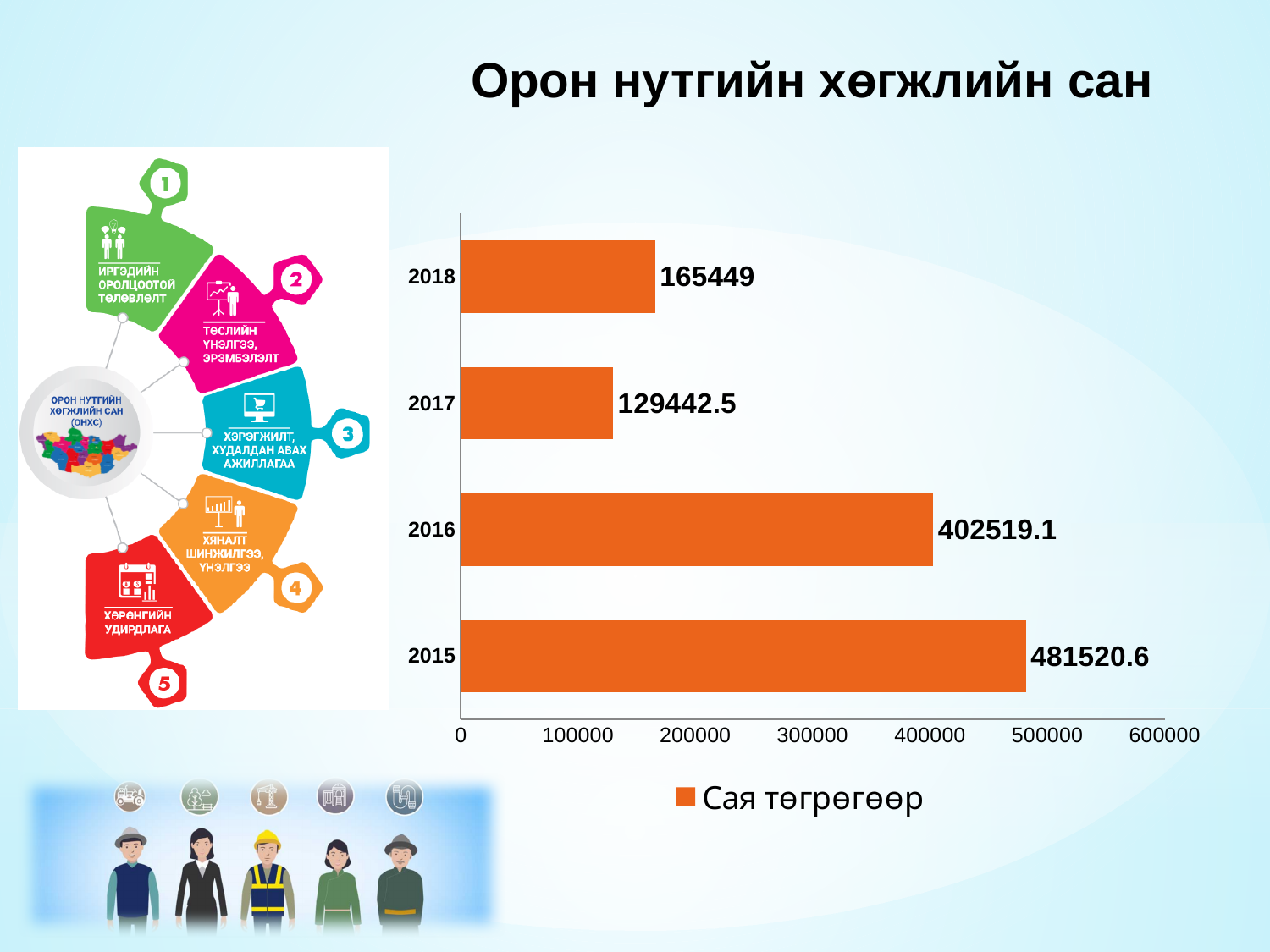
How many years are shown in the chart? 4 What is the difference between the values for 2018 and 2017? 36006.5 Which year has the lowest value? 2017 What is the difference between the values for 2015 and 2016? 79001.5 What is the value for 2016? 402519.1 What kind of chart is shown on the slide? Bar chart Which year has the highest value? 2015 What is the value for 2015? 481520.6 Which is larger, the value for 2018 or the value for 2016? 2016 What is the legend entry of the chart? Сая төгрөгөөр What is the value for 2018? 165449 What is the value for 2017? 129442.5